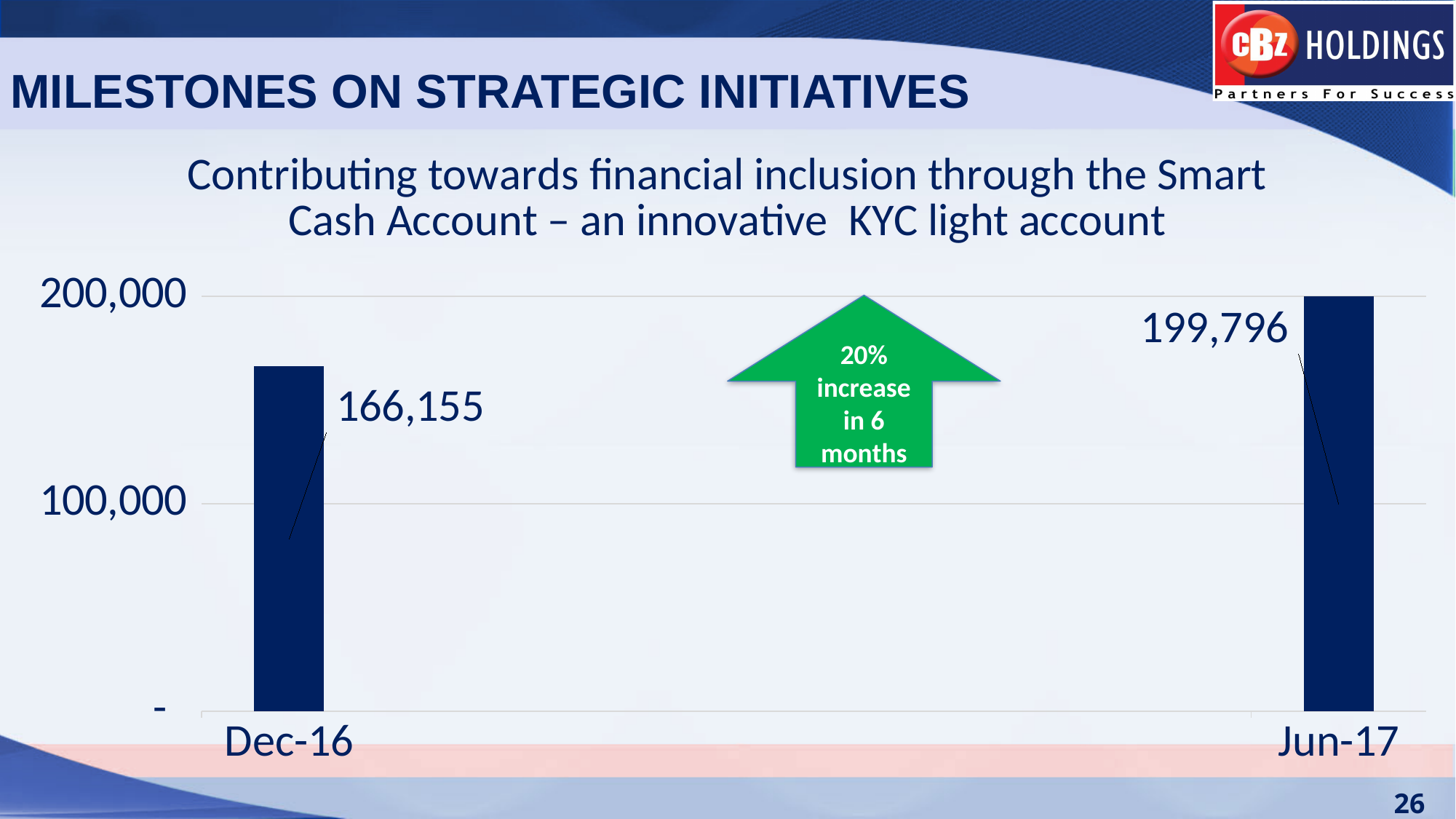
How many categories are shown on the x axis? 2 What percentage increase does the green arrow on the chart state? 20% increase in 6 months Which is larger, the value for Dec-16 or the value for Jun-17? Jun-17 Do the values rise or fall from Dec-16 to Jun-17? rise What is the difference between the Jun-17 and Dec-16 values? 33,641 Is the value for Jun-17 greater or less than 200,000? less What kind of chart is shown on the slide? bar chart What is the value for Dec-16? 166,155 Is the value for Dec-16 greater or less than 100,000? greater Which category has the lowest value? Dec-16 Which category has the highest value? Jun-17 What is the value for Jun-17? 199,796